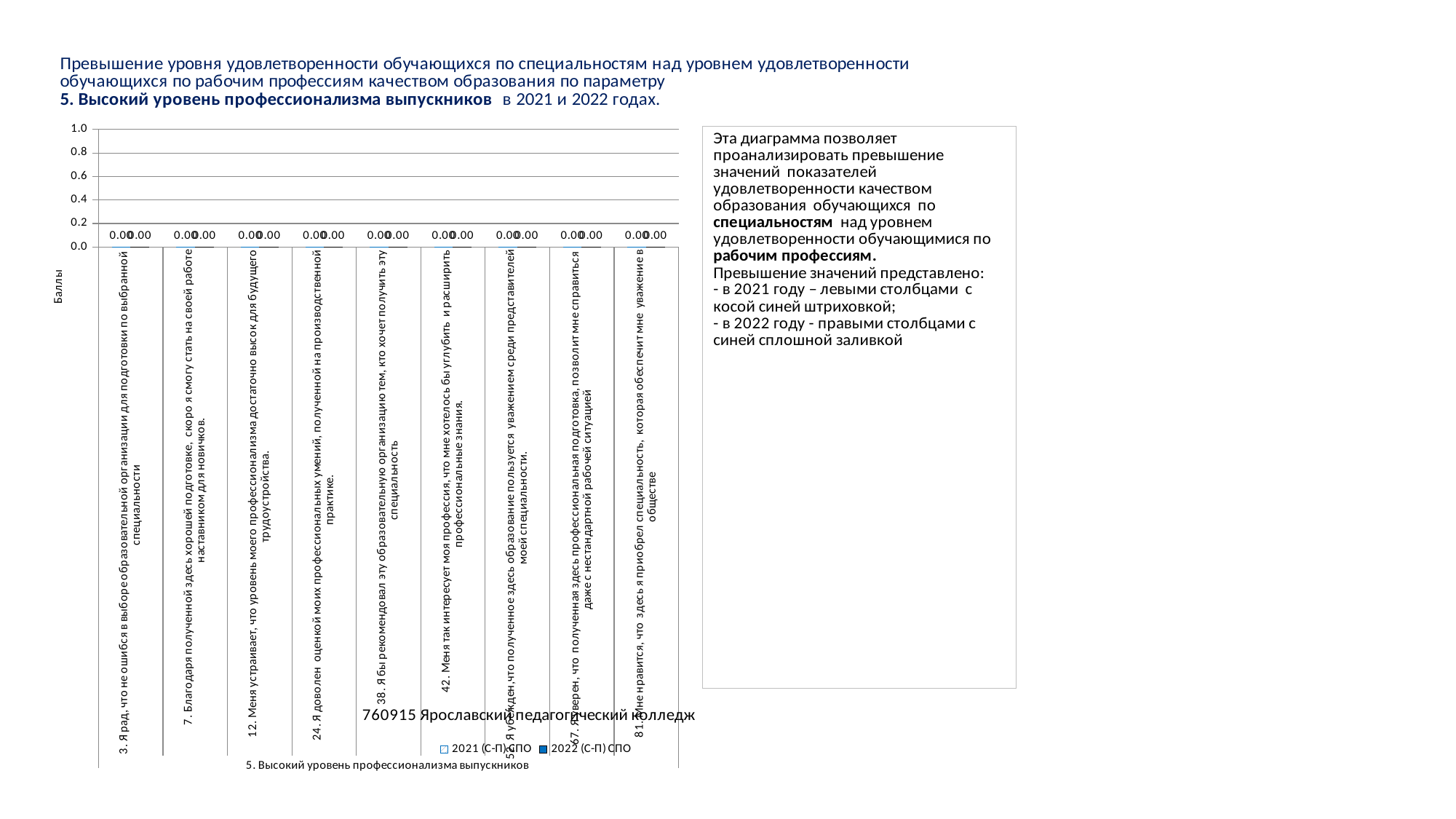
How many series does the chart legend list? 2 How many categories (statements) are plotted along the x axis of the chart? 9 Is the value for statement 7 in the 2021 (С-П) СПО series greater or less than 0.2? less What is the label of the vertical (y) axis of the chart? Баллы What is the value of the 2021 (С-П) СПО series for statement 3 ("Я рад, что не ошибся в выборе образовательной организации...")? 0.00 What are the two series named in the chart legend? 2021 (С-П) СПО and 2022 (С-П) СПО What kind of chart is shown on the slide? bar chart What is the value of the 2022 (С-П) СПО series for statement 12 ("Меня устраивает, что уровень моего профессионализма достаточно высок...")? 0.00 What is the difference between the 2022 (С-П) СПО and 2021 (С-П) СПО values for statement 24 ("Я доволен оценкой моих профессиональных умений...")? 0.00 What is the value of the 2022 (С-П) СПО series for statement 81 ("Мне нравится, что здесь я приобрел специальность...")? 0.00 What is the value of the 2021 (С-П) СПО series for statement 42 ("Меня так интересует моя профессия...")? 0.00 What is the highest tick value shown on the y axis of the chart? 1.0